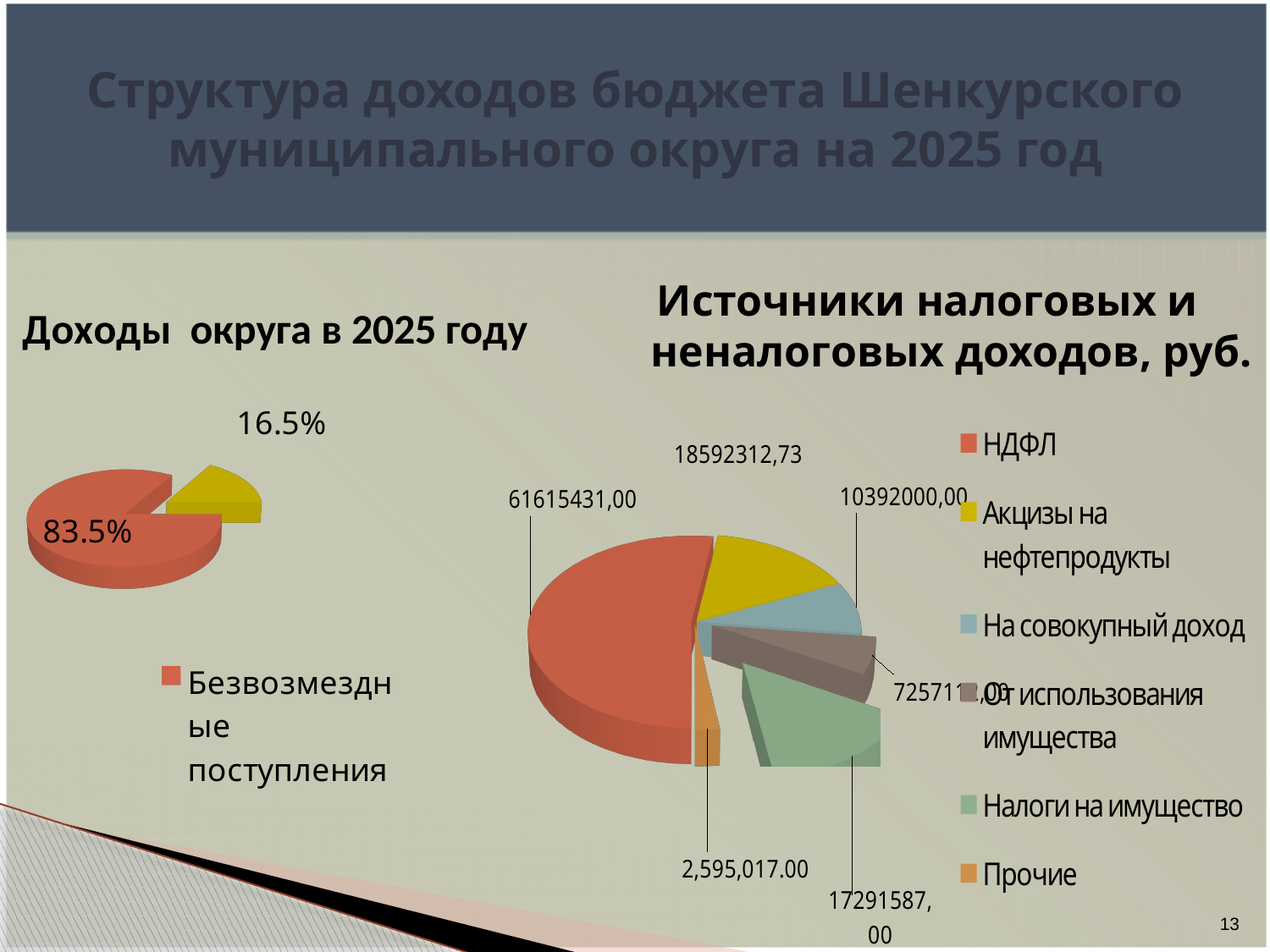
In the right chart "Источники налоговых и неналоговых доходов, руб.", what is the value for НДФЛ? 61615431,00 In the left chart "Доходы округа в 2025 году", what share is shown for Безвозмездные поступления? 83.5% How many categories does the legend of the right chart "Источники налоговых и неналоговых доходов, руб." list? 6 In the right chart "Источники налоговых и неналоговых доходов, руб.", what is the value for Акцизы на нефтепродукты? 18592312,73 In the right chart "Источники налоговых и неналоговых доходов, руб.", which is larger: Акцизы на нефтепродукты or Налоги на имущество? Акцизы на нефтепродукты In the left chart "Доходы округа в 2025 году", what percentage is shown on the smaller (yellow) slice? 16.5% In the right chart "Источники налоговых и неналоговых доходов, руб.", which category has the smallest value? Прочие In the right chart "Источники налоговых и неналоговых доходов, руб.", what is the value for Прочие? 2,595,017.00 In the right chart "Источники налоговых и неналоговых доходов, руб.", what is the value for Налоги на имущество? 17291587,00 In the right chart "Источники налоговых и неналоговых доходов, руб.", which category has the largest value? НДФЛ What kind of chart is the left chart titled "Доходы округа в 2025 году"? pie chart In the right chart "Источники налоговых и неналоговых доходов, руб.", what is the value for На совокупный доход? 10392000,00